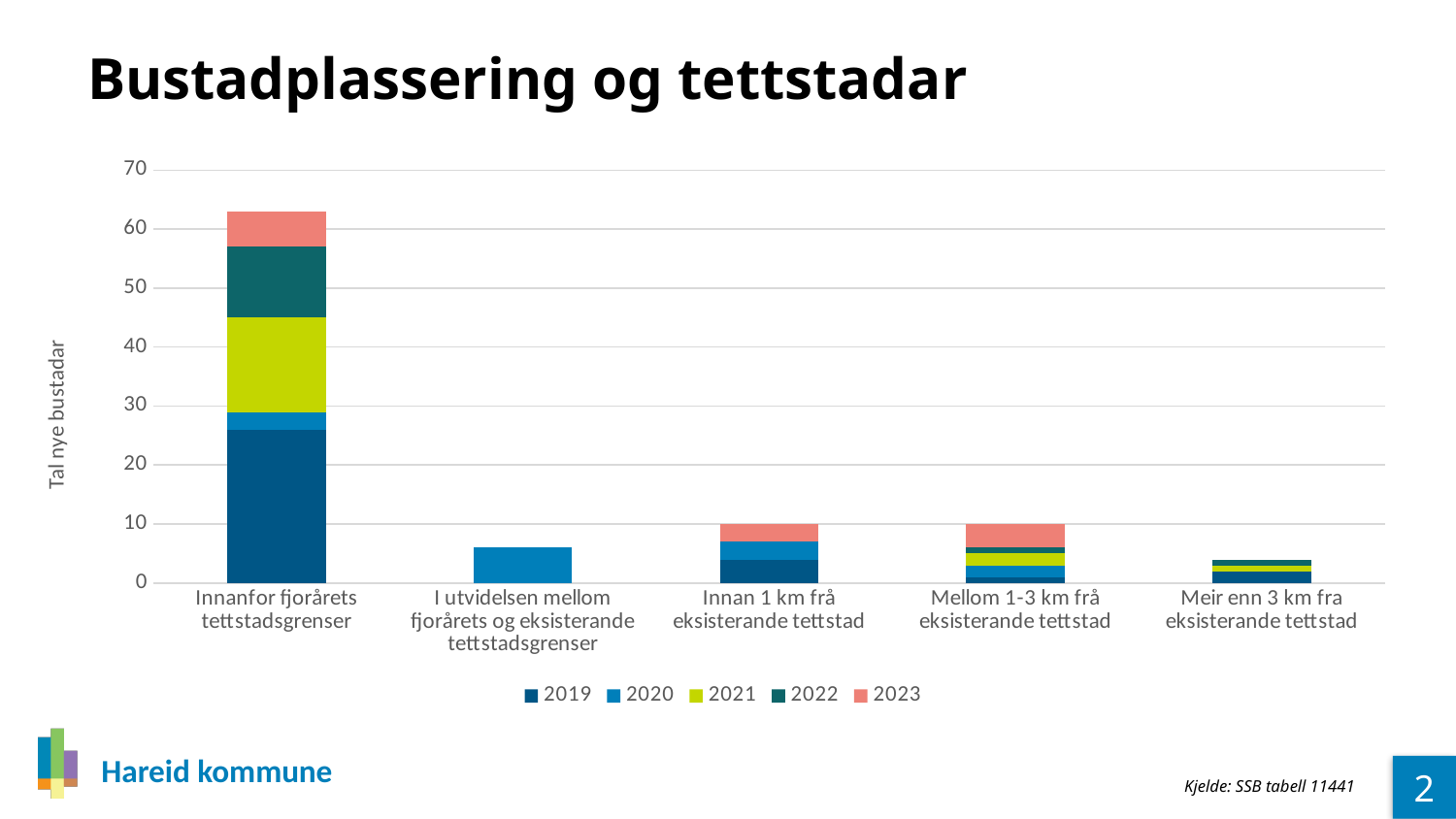
What kind of chart is shown on the slide? Stacked bar chart Which single year series makes up the entire bar for 'I utvidelsen mellom fjorårets og eksisterande tettstadsgrenser'? 2020 How many categories are shown on the x axis of the chart? 5 Is the total for 'I utvidelsen mellom fjorårets og eksisterande tettstadsgrenser' greater or less than 10? less Is the total for 'Innanfor fjorårets tettstadsgrenser' greater or less than 60? greater What is the title of the chart on the slide? Bustadplassering og tettstadar Which category has the lowest total number of new dwellings? Meir enn 3 km fra eksisterande tettstad Is the 2019 value for 'Innanfor fjorårets tettstadsgrenser' greater or less than 20? greater Which category has the highest total number of new dwellings? Innanfor fjorårets tettstadsgrenser How many series does the legend list? 5 Which has a larger total: 'Innanfor fjorårets tettstadsgrenser' or 'Innan 1 km frå eksisterande tettstad'? Innanfor fjorårets tettstadsgrenser